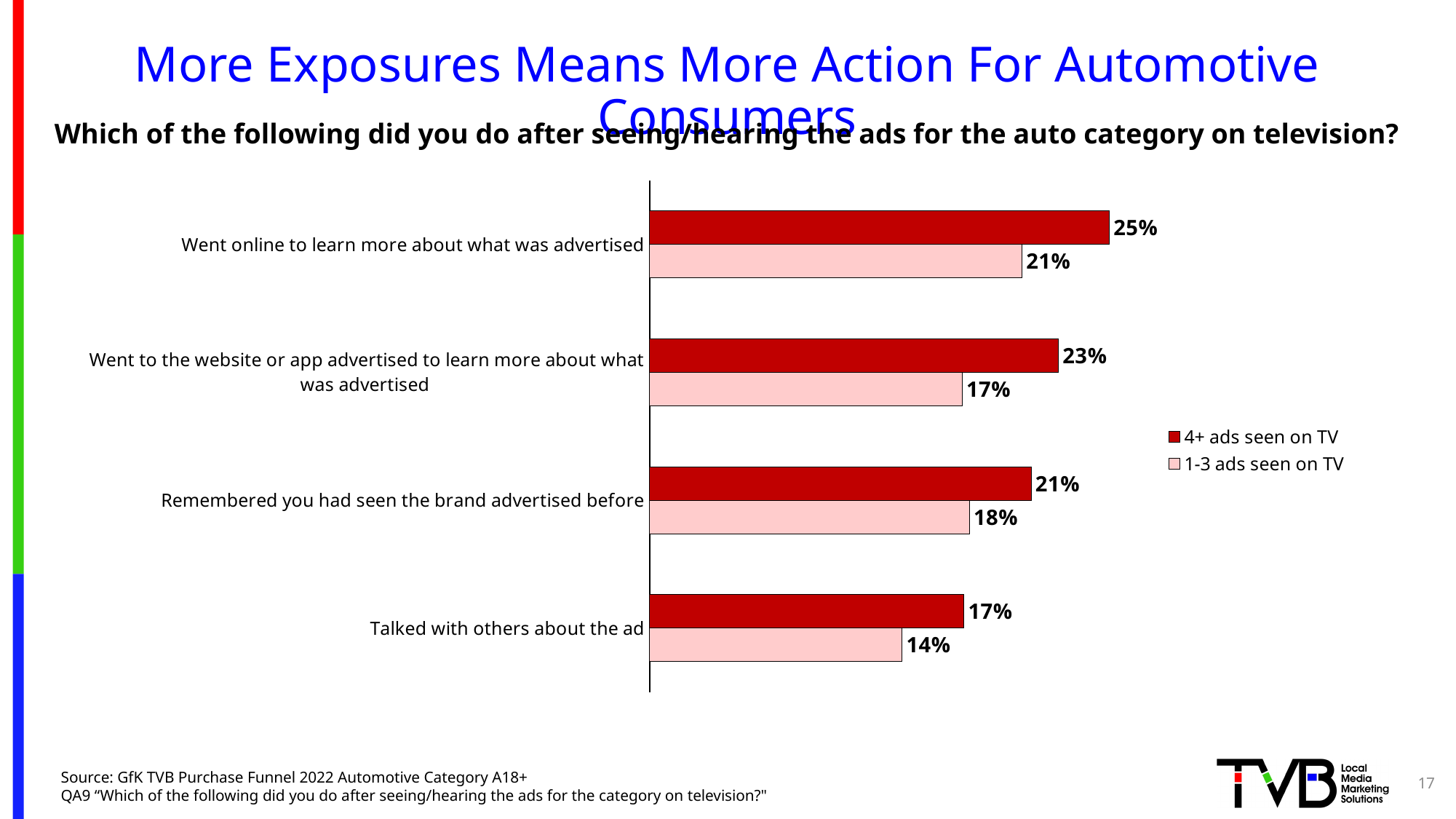
What are the two series named in the legend? 4+ ads seen on TV; 1-3 ads seen on TV For 'Talked with others about the ad', which group has the larger value: 4+ ads seen on TV or 1-3 ads seen on TV? 4+ ads seen on TV How many series does the legend list? 2 What percentage of those who saw 4+ ads on TV went online to learn more about what was advertised? 25% How many actions (categories) are shown in the chart? 4 Which action has the highest value for the 4+ ads seen on TV series? Went online to learn more about what was advertised Which action has the lowest value for the 1-3 ads seen on TV series? Talked with others about the ad What is the value for 'Remembered you had seen the brand advertised before' among those who saw 1-3 ads on TV? 18% What percentage of those who saw 1-3 ads on TV talked with others about the ad? 14% What is the difference between the 4+ ads and 1-3 ads values for 'Remembered you had seen the brand advertised before'? 3% What is the difference between the 4+ ads and 1-3 ads values for 'Went to the website or app advertised to learn more about what was advertised'? 6% What type of chart is shown on the slide? Bar chart